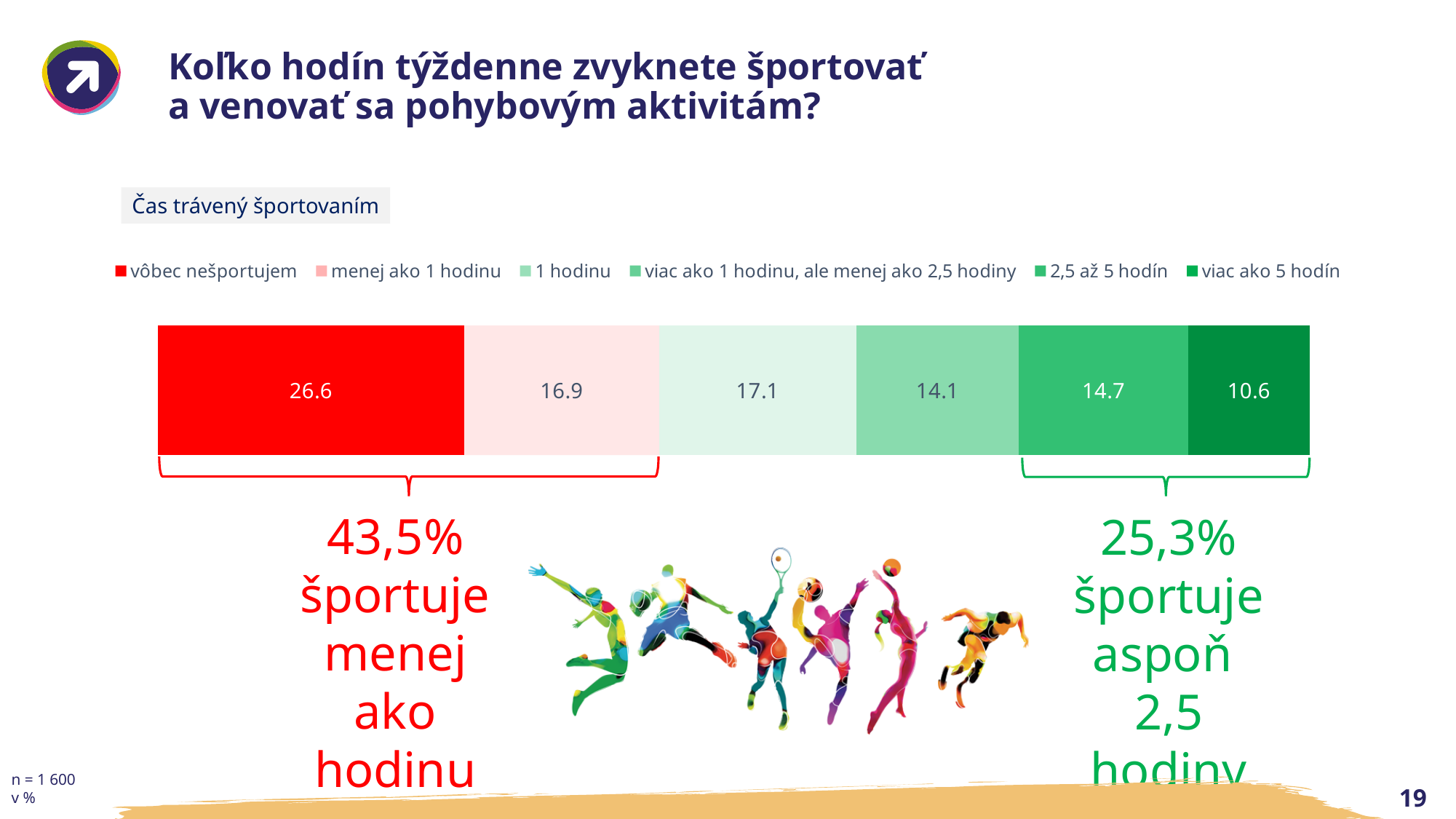
Which is larger: the value for "2,5 až 5 hodín" or the value for "viac ako 1 hodinu, ale menej ako 2,5 hodiny"? 2,5 až 5 hodín What is the value for "vôbec nešportujem"? 26.6 What is the difference between the values for "vôbec nešportujem" and "menej ako 1 hodinu"? 9.7 What is the value for "viac ako 5 hodín"? 10.6 Which category has the lowest value? viac ako 5 hodín What is the title of the chart? Čas trávený športovaním What is the value for "1 hodinu"? 17.1 What is the value for "2,5 až 5 hodín"? 14.7 Which category has the highest value? vôbec nešportujem How many series does the legend list? 6 What is the total of all segments in the stacked bar? 100.0 What type of chart is shown on the slide? Stacked bar chart